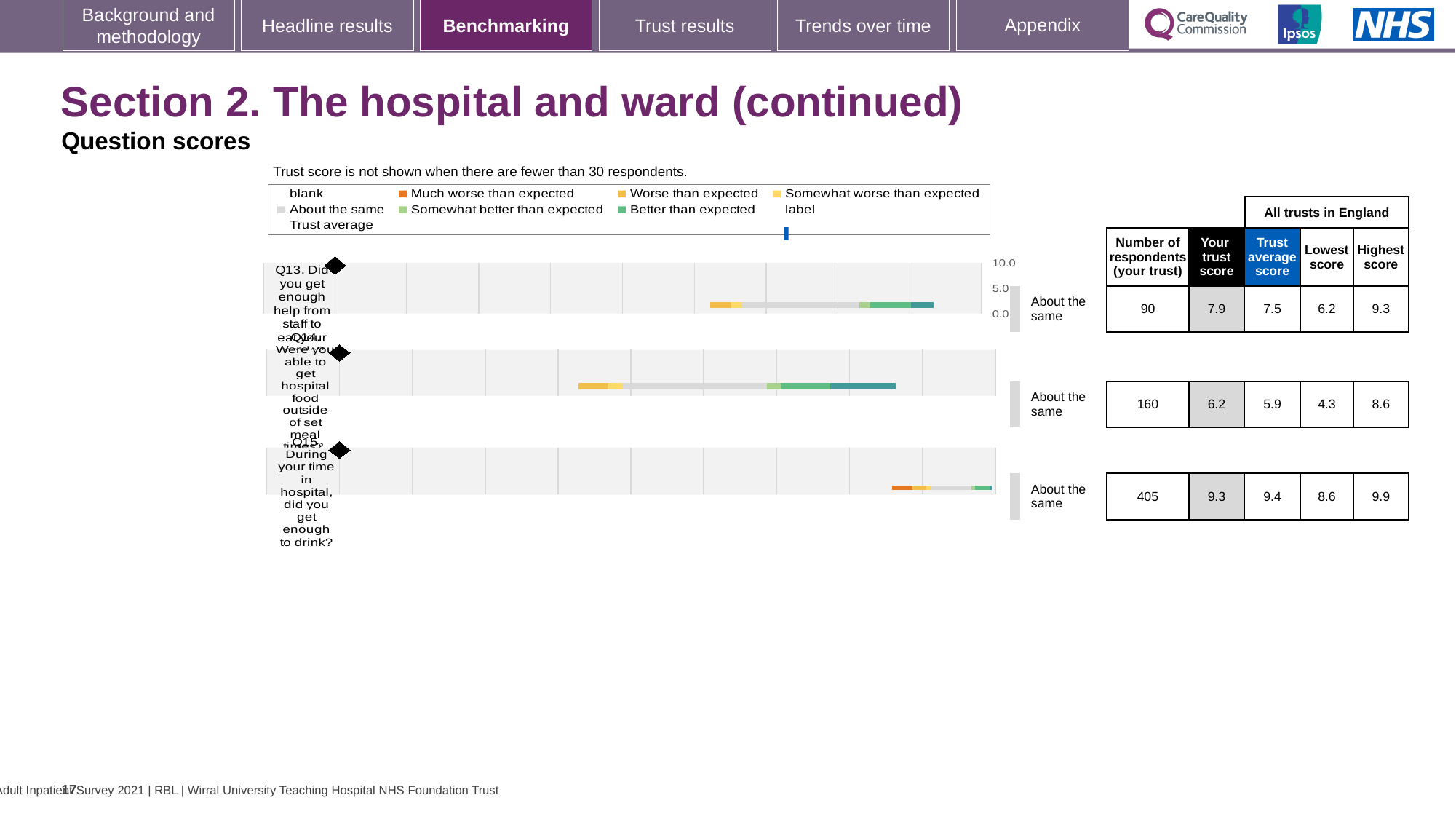
What is the trust score for Q13 (Did you get enough help from staff to eat your meals?)? 7.9 What is the lowest score in England for Q13? 6.2 What is the difference between this trust's score and the trust average score for Q13? 0.4 How many questions are plotted in the chart? 3 What is the highest score in England for Q14? 8.6 Which question has the fewest respondents at this trust? Q13 What benchmark category is shown for Q14 (Were you able to get hospital food outside of set meal times?)? About the same What kind of chart is used to show the question scores? Bar chart Which has the larger trust score for this trust: Q14 or Q15? Q15 What is the trust average score across all trusts in England for Q14 (hospital food outside of set meal times)? 5.9 How many respondents answered Q15 (did you get enough to drink?) at this trust? 405 Which question has the highest trust score for this trust? Q15